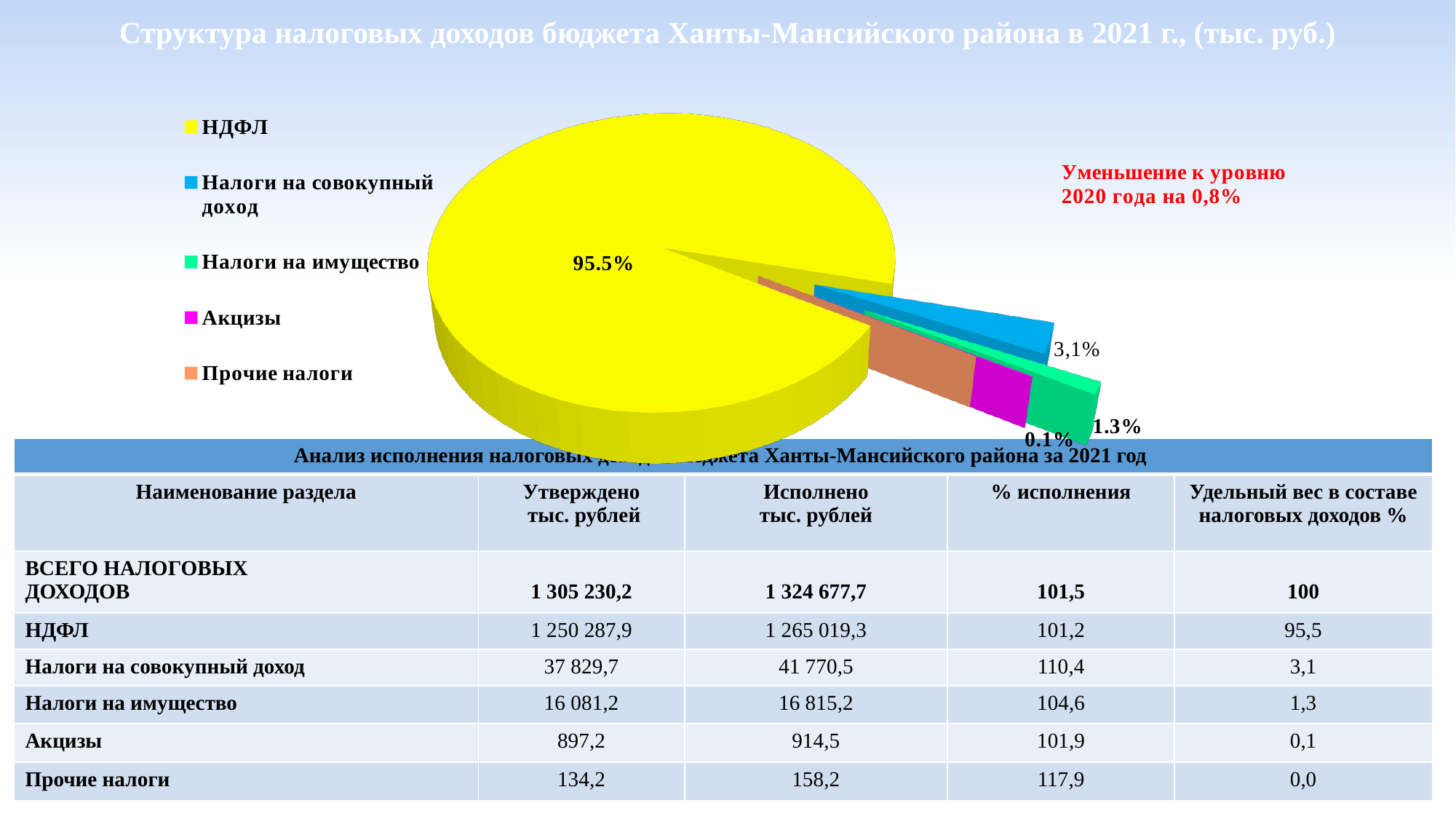
Which is larger in the pie chart: Налоги на совокупный доход or Налоги на имущество? Налоги на совокупный доход What share of the pie chart does НДФЛ have? 95.5% What share of the pie chart does Налоги на совокупный доход have? 3,1% What share of the pie chart does Налоги на имущество have? 1.3% What is the title of the slide containing the pie chart? Структура налоговых доходов бюджета Ханты-Мансийского района в 2021 г., (тыс. руб.) Which category has the largest slice in the pie chart? НДФЛ What share of the pie chart does Акцизы have? 0.1% What colour is the НДФЛ slice in the pie chart? yellow Which is larger in the pie chart: Налоги на имущество or Акцизы? Налоги на имущество How many entries does the legend of the pie chart list? 5 What kind of chart is shown on the slide? pie chart